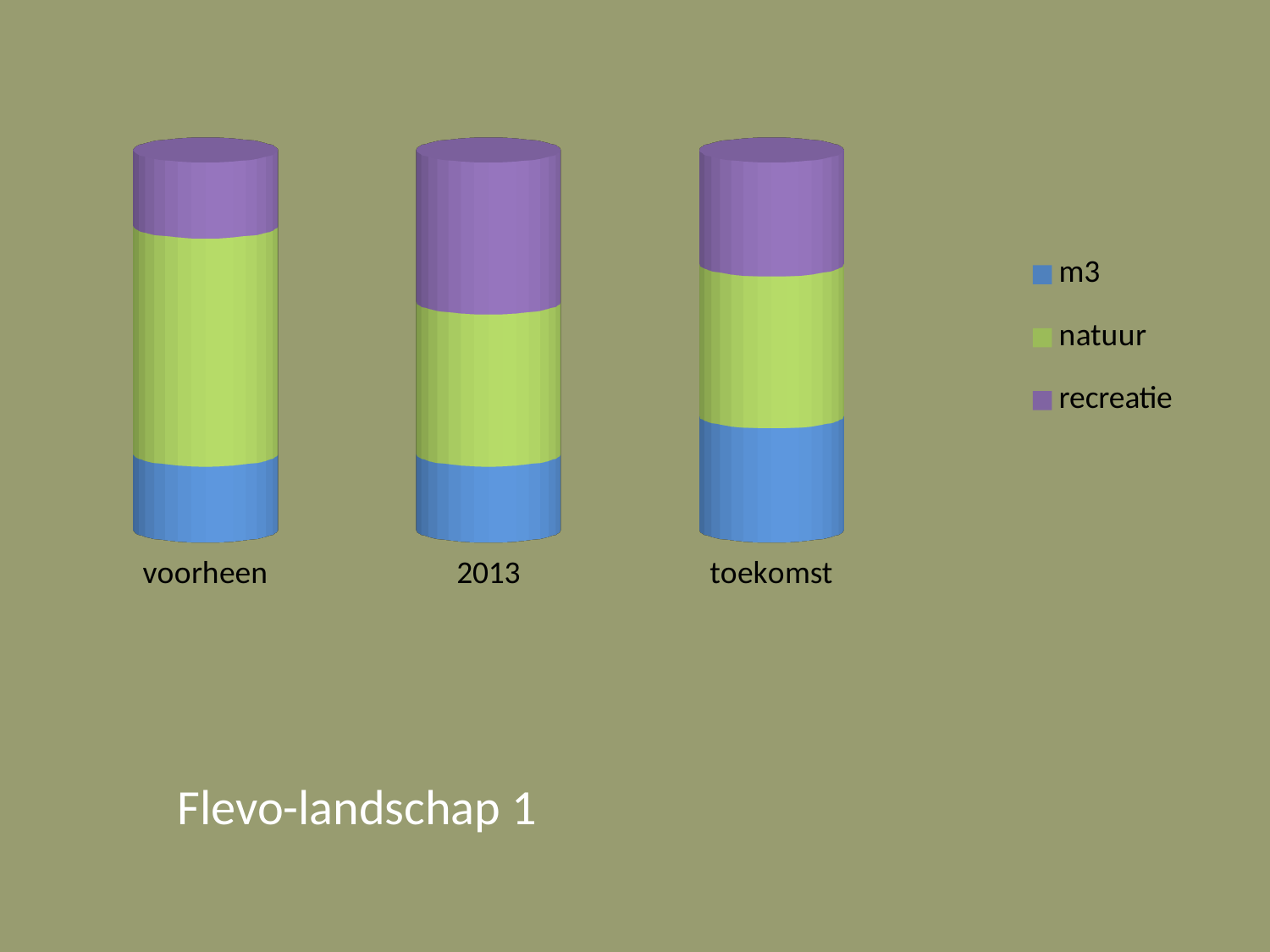
Is the m3 segment larger for toekomst or for voorheen? toekomst What kind of chart is shown on the slide? bar chart Which category has the largest natuur segment? voorheen Which category has the largest recreatie segment? 2013 How many series does the chart's legend list? 3 Which category has the smallest recreatie segment? voorheen Is the natuur segment larger for voorheen or for 2013? voorheen Is the recreatie segment larger for 2013 or for toekomst? 2013 What are the category labels along the x axis of the chart? voorheen, 2013, toekomst How many categories are shown along the x axis of the chart? 3 Which series are listed in the chart's legend? m3, natuur, recreatie Which category has the largest m3 segment? toekomst